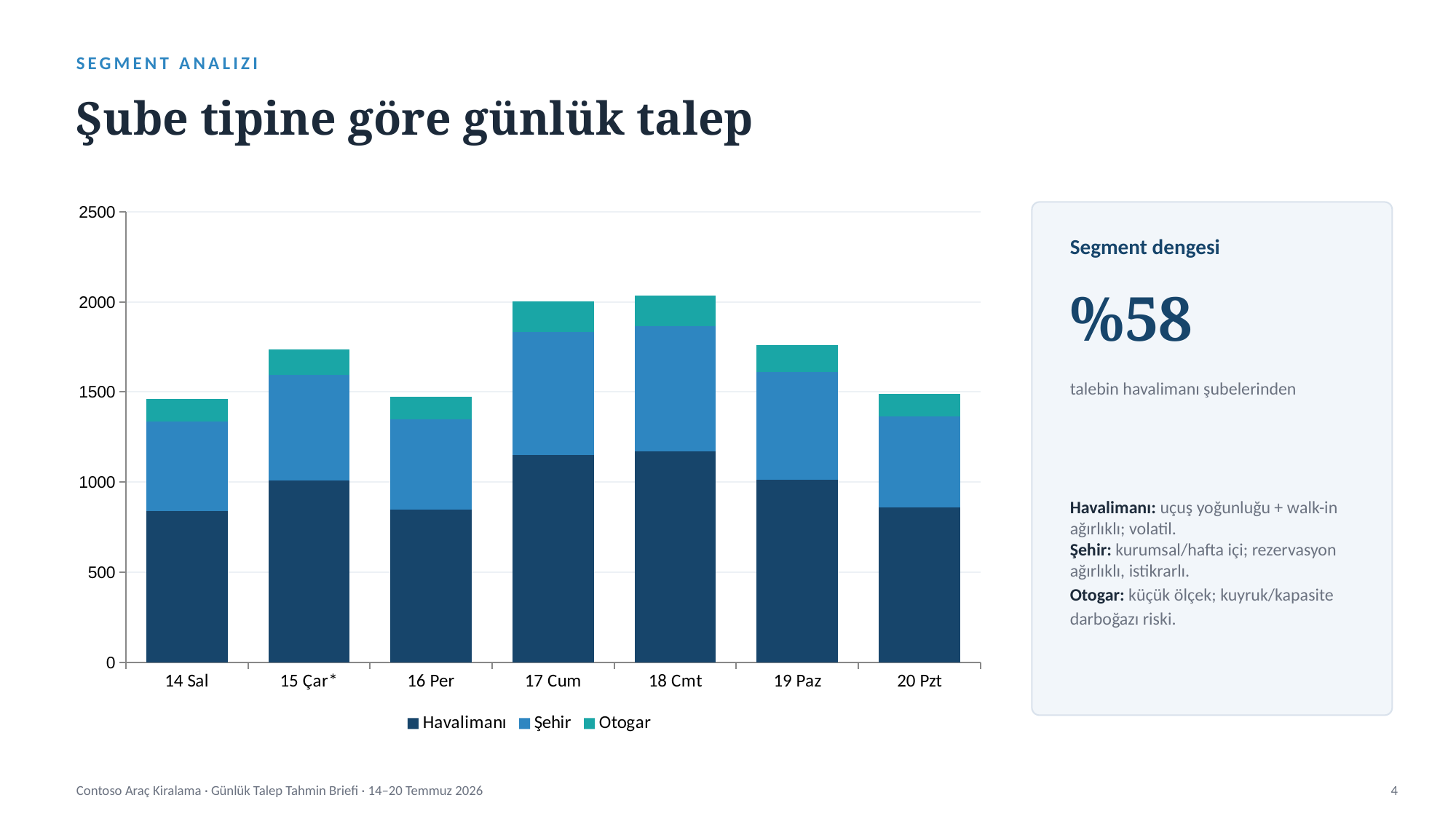
Is the total stacked value for 19 Paz greater or less than 2000? less How many series does the chart legend list? 3 What kind of chart is shown on the slide? Stacked bar chart Is the Havalimanı value for 17 Cum greater or less than 1000? greater How many days (categories) are shown on the x axis of the chart? 7 Is the total stacked value for 15 Çar* greater or less than 1500? greater What are the three series listed in the chart legend? Havalimanı, Şehir, Otogar What is the title of the chart on the slide? Şube tipine göre günlük talep Which has the larger total stacked value, 16 Per or 17 Cum? 17 Cum Do the total stacked values rise or fall from 18 Cmt to 20 Pzt? fall